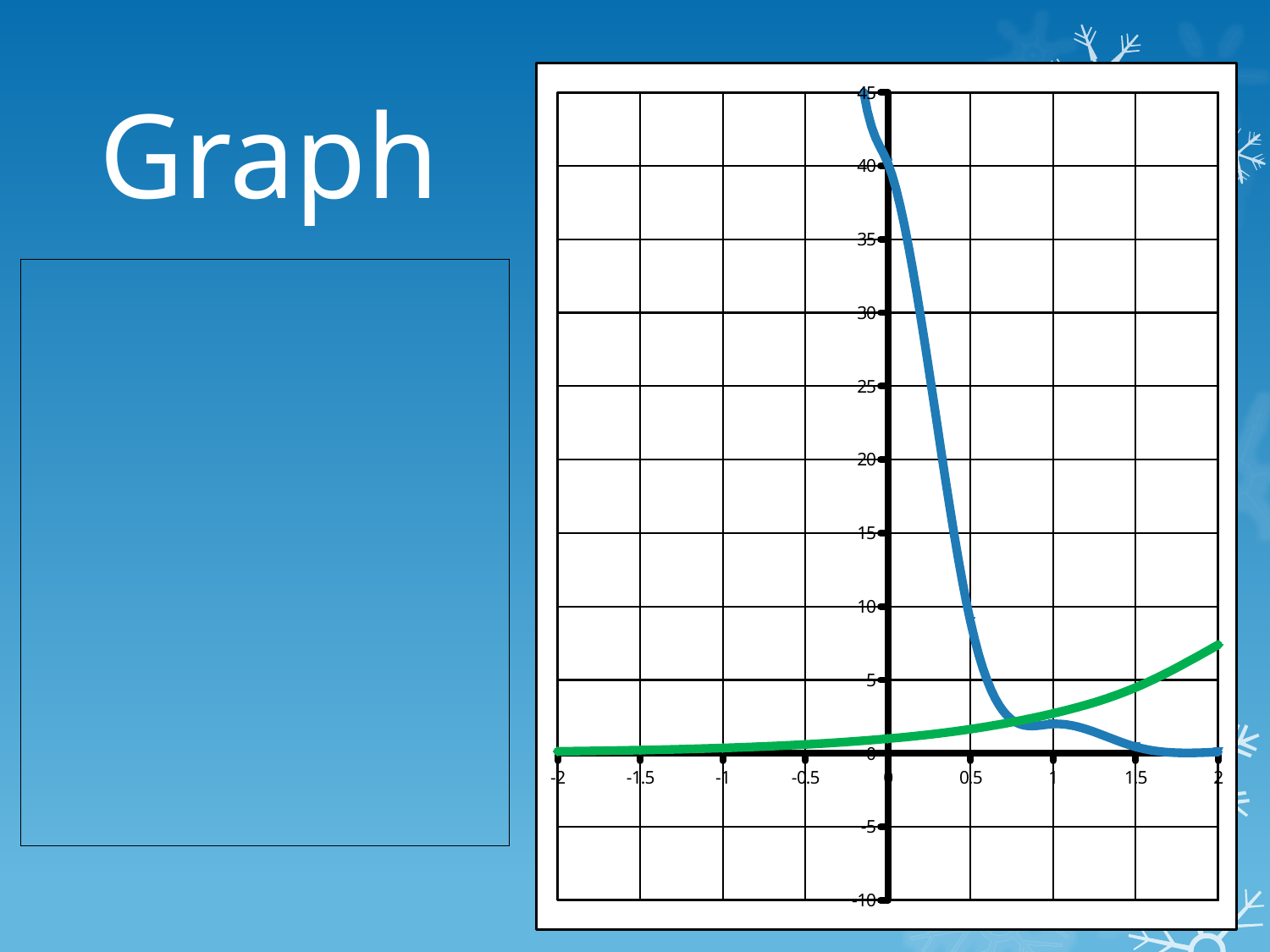
What is the title of the slide containing the chart? Graph Is the value of the green line at x = -2 greater or less than 5? less Is the value of the green line at x = 2 greater or less than 5? greater How many lines are plotted on the chart? 2 What kind of chart is shown on the slide? line chart Is the value of the blue line at x = 1 greater or less than 5? less At x = 0, which line has the higher value, the blue line or the green line? blue line What is the highest value labelled on the chart's vertical axis? 45 At x = 2, which line has the higher value, the blue line or the green line? green line Does the blue line rise or fall as x increases from 0 to 2? fall Does the green line rise or fall as x increases from -2 to 2? rise